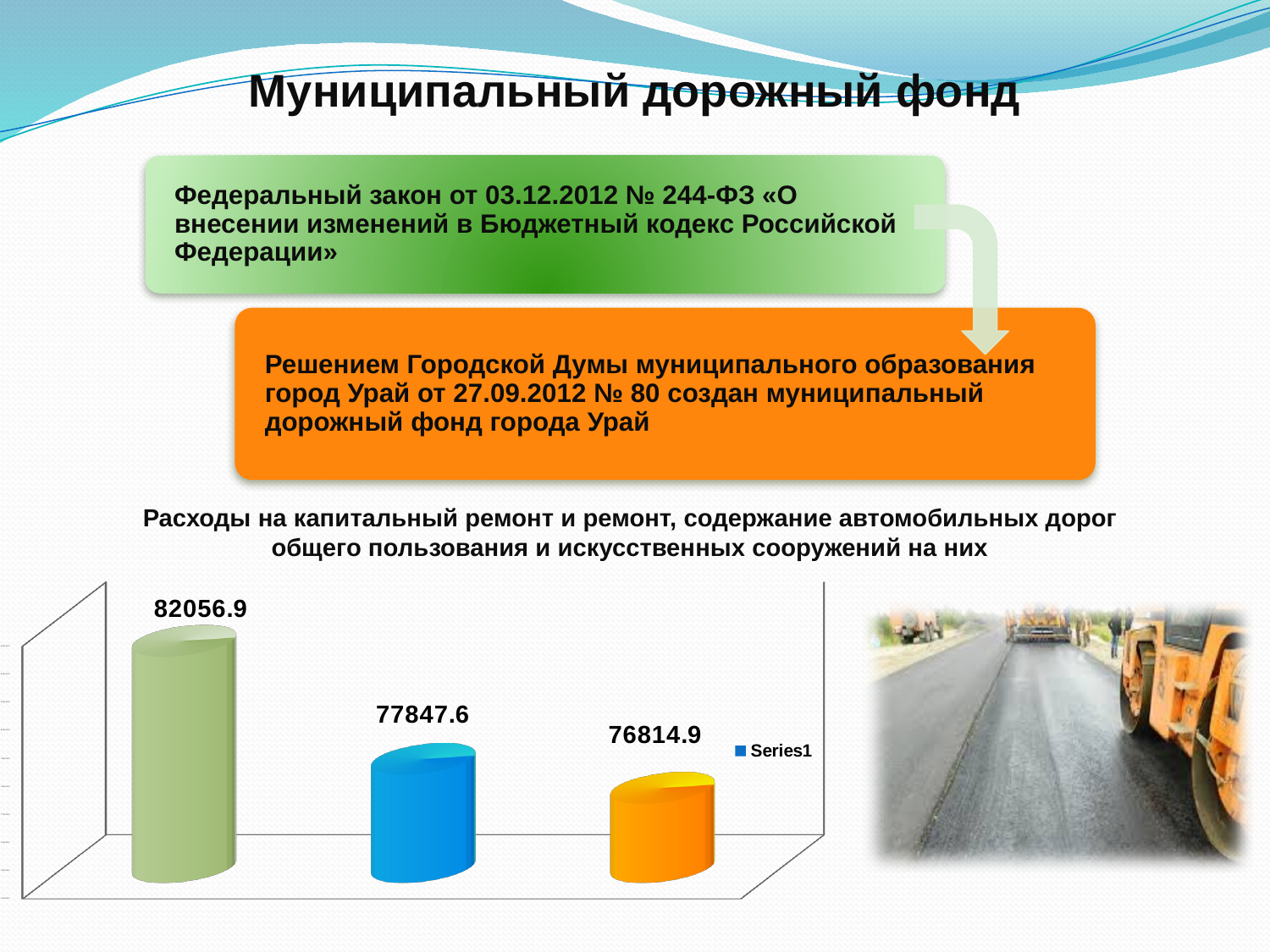
What is the value shown on the first (green) bar of the chart? 82056.9 What type of chart is shown on the slide? Bar chart Which bar has the highest value in the chart? The first (green) bar, 82056.9 What is the value shown on the middle (blue) bar of the chart? 77847.6 How many bars are plotted in the chart? 3 Which bar has the lowest value in the chart? The third (orange) bar, 76814.9 What is the value shown on the third (orange) bar of the chart? 76814.9 What is the difference between the second bar (77847.6) and the third bar (76814.9)? 1032.7 Do the values rise or fall from left to right across the bars? Fall What is the difference between the first bar (82056.9) and the second bar (77847.6)? 4209.3 How many series does the chart legend list? 1 Which is larger, the value of the blue bar or the value of the orange bar? The blue bar (77847.6)